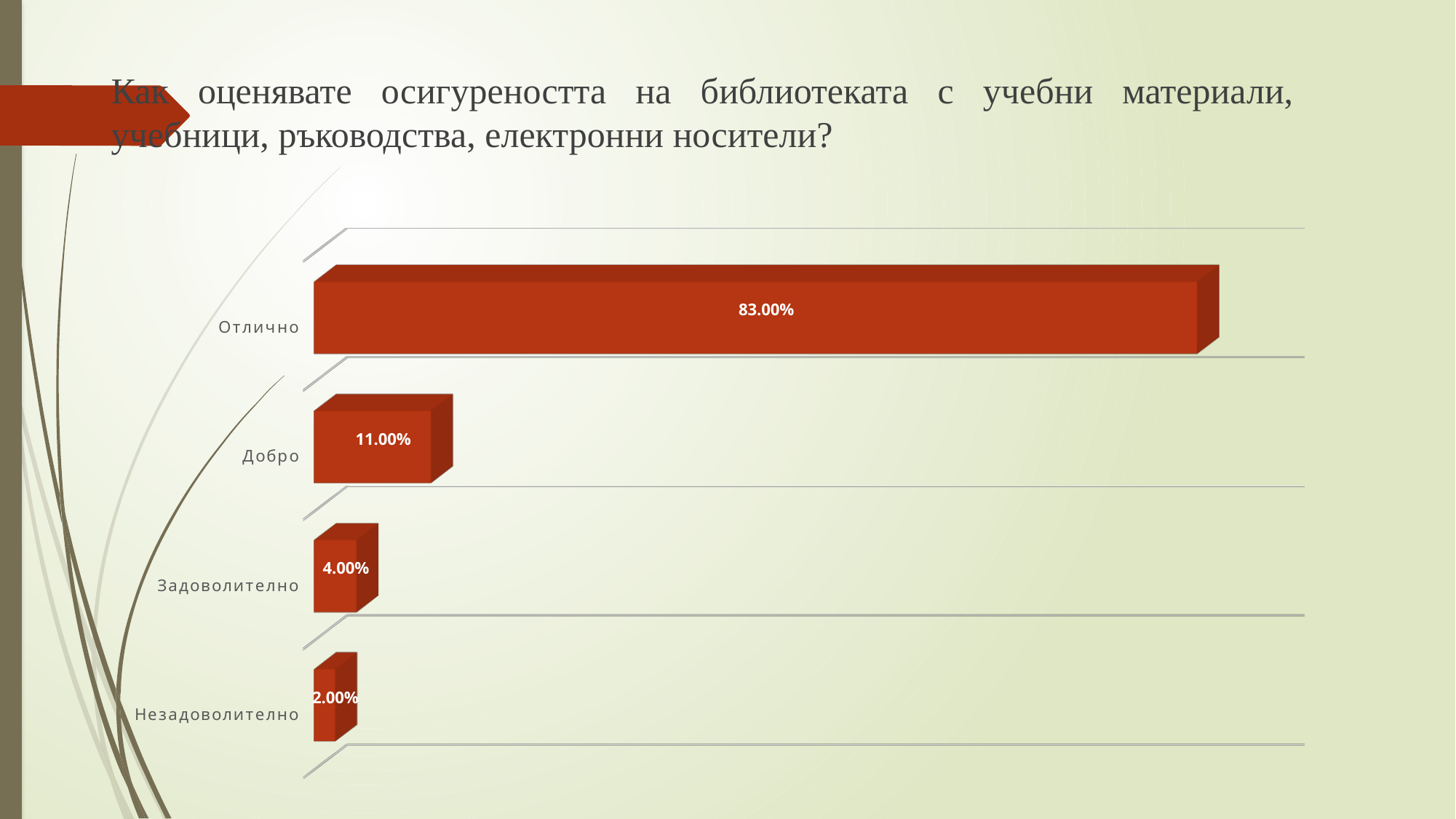
Which is larger, the value for Добро or the value for Задоволително? Добро Which category has the lowest value? Незадоволително How many categories are shown in the chart? 4 What is the value for Задоволително? 4.00% What is the value for Добро? 11.00% What is the value for Незадоволително? 2.00% Which category has the highest value? Отлично What is the value for Отлично? 83.00% What is the difference between the values for Отлично and Добро? 72.00% What kind of chart is shown on the slide? Bar chart What is the difference between the values for Задоволително and Незадоволително? 2.00% What colour are the bars in the chart? Red